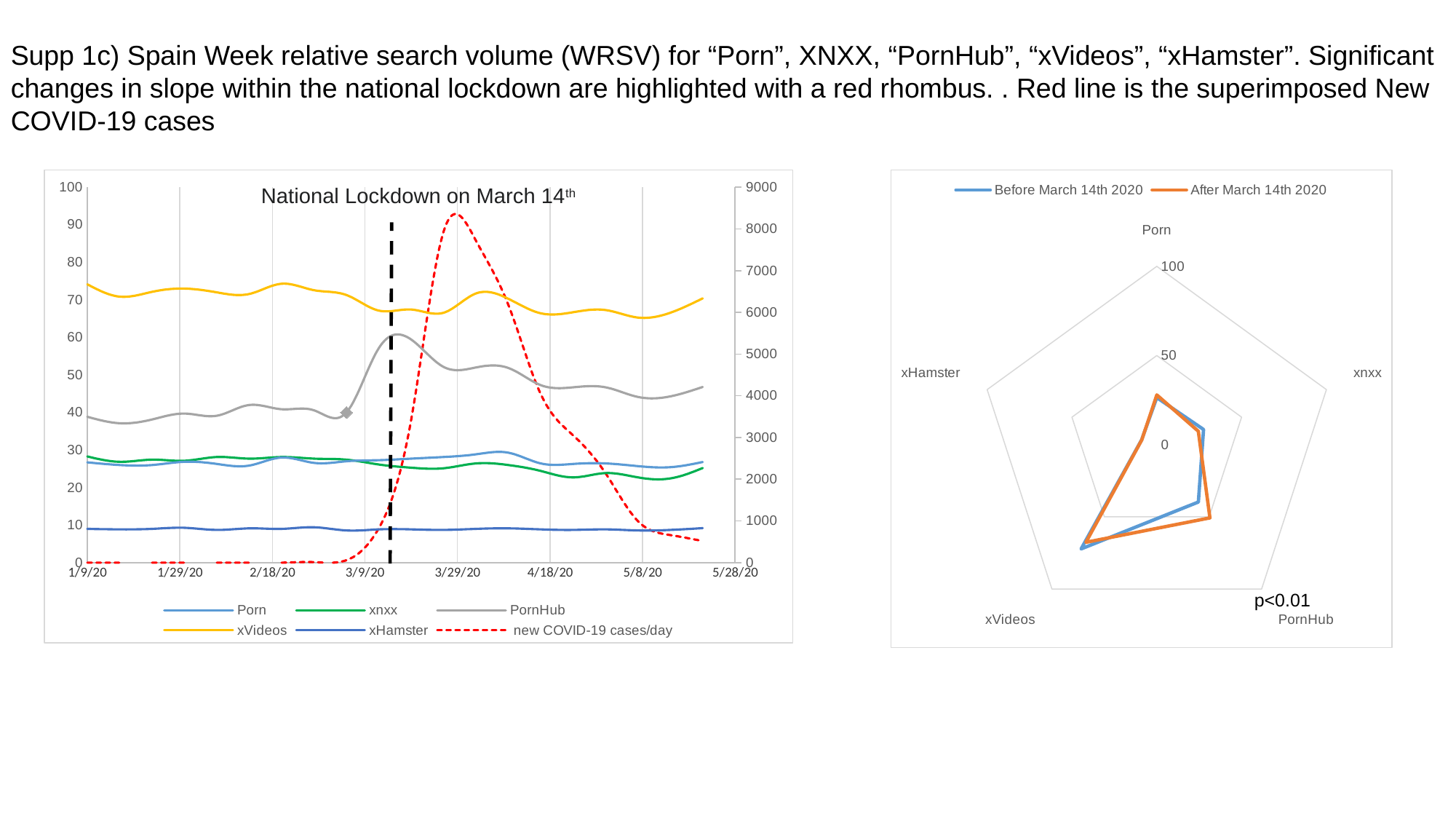
On the right chart, is the value for xHamster greater or less than 50? less What kind of chart is the right chart? radar chart On the left chart, which search term series has the lowest values throughout the period? xHamster On the left chart, is the value for xHamster on 3/29/20 greater or less than 20? less On the left chart, is the peak of new COVID-19 cases/day greater or less than 7000? greater What kind of chart is the left chart? line chart How many series does the legend of the left chart list? 6 On the left chart, which search term series has the highest values throughout the period? xVideos On the left chart, which is larger on 4/18/20, xVideos or PornHub? xVideos How many series does the legend of the right chart list? 2 How many categories does the right chart have? 5